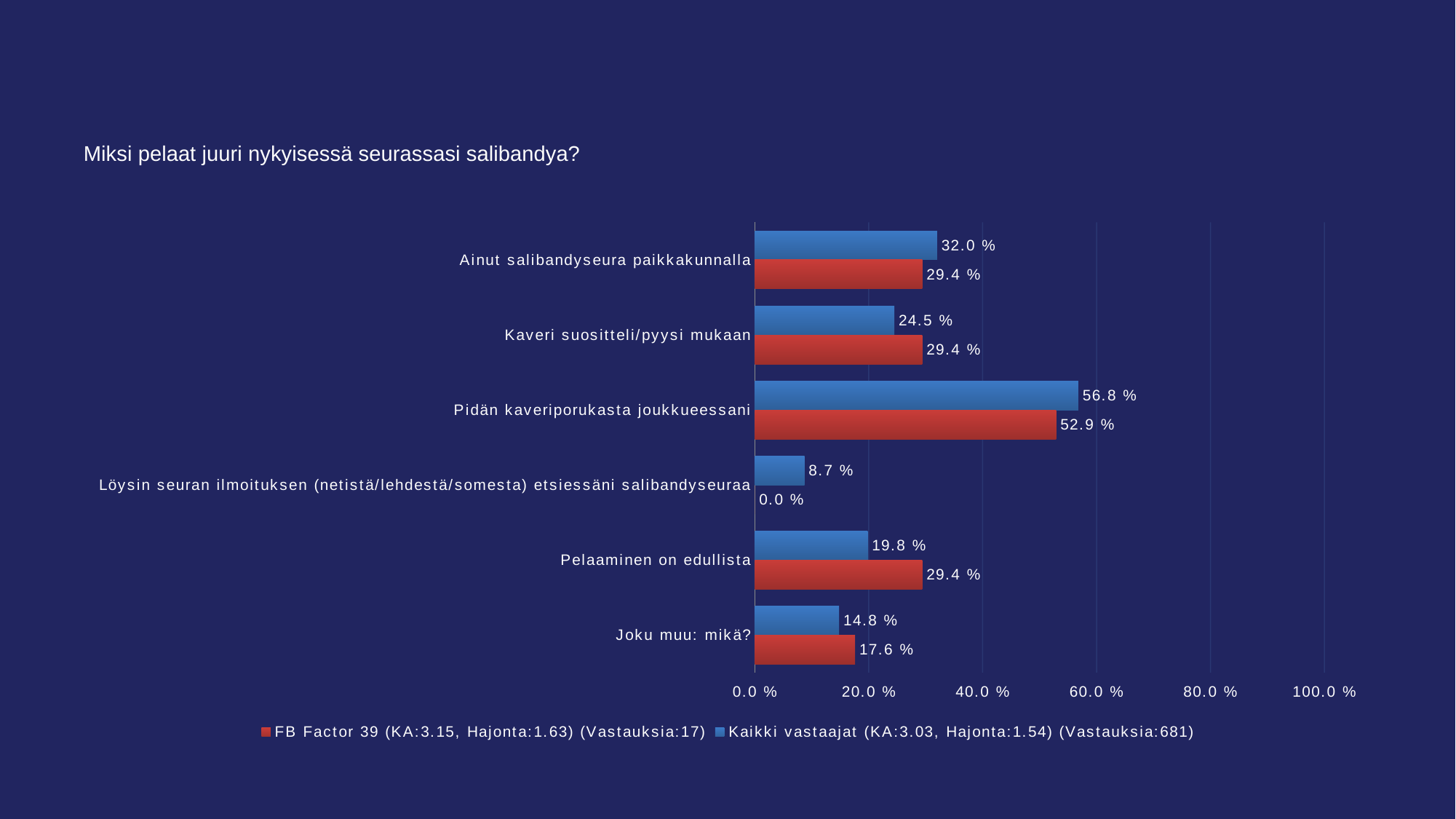
Which series has the larger value for "Ainut salibandyseura paikkakunnalla"? Kaikki vastaajat What kind of chart is shown on the slide? Bar chart Is the value for "Kaikki vastaajat" in "Kaveri suositteli/pyysi mukaan" greater or less than 20.0 %? greater What is the value for "FB Factor 39" in the category "Löysin seuran ilmoituksen (netistä/lehdestä/somesta) etsiessäni salibandyseuraa"? 0.0 % What is the value for "FB Factor 39" in the category "Joku muu: mikä?"? 17.6 % How many categories are shown on the chart? 6 What is the value for "Kaikki vastaajat" in the category "Pidän kaveriporukasta joukkueessani"? 56.8 % How many series does the legend list? 2 Which category has the highest value for "Kaikki vastaajat"? Pidän kaveriporukasta joukkueessani Which category has the lowest value for "FB Factor 39"? Löysin seuran ilmoituksen (netistä/lehdestä/somesta) etsiessäni salibandyseuraa What is the difference between the "Kaikki vastaajat" and "FB Factor 39" values for "Pelaaminen on edullista"? 9.6 % What colour are the bars for the "FB Factor 39" series? Red